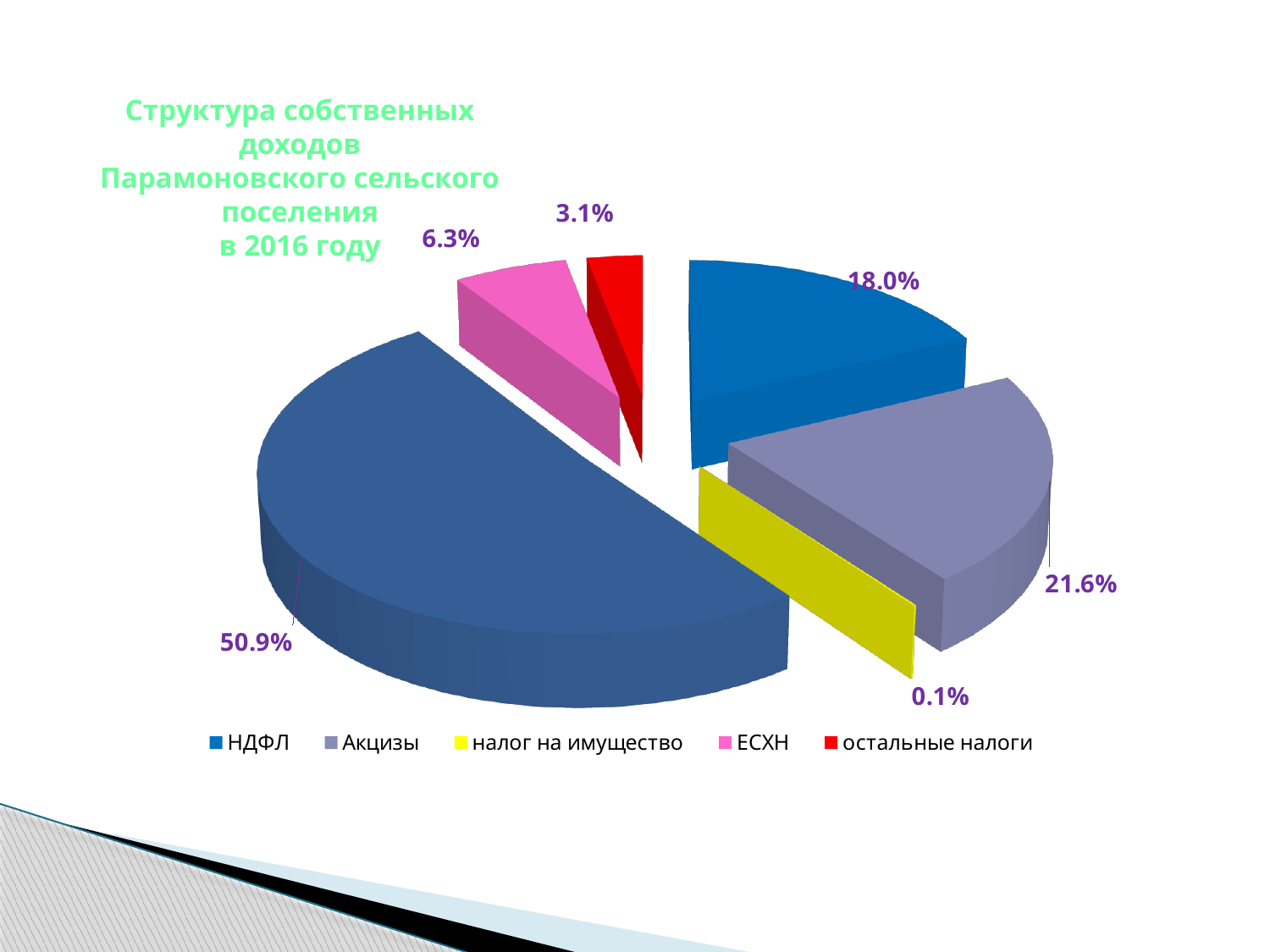
What is the largest percentage label shown on the pie chart? 50.9% What percentage does the Акцизы slice represent? 21.6% What share does налог на имущество have? 0.1% Which is larger, ЕСХН or остальные налоги? ЕСХН What percentage is labelled for НДФЛ? 18.0% How many entries does the legend list? 5 What is the value of the остальные налоги slice? 3.1% By how many percentage points does Акцизы exceed НДФЛ? 3.6% What percentage is shown for ЕСХН? 6.3% Which year does the chart title refer to? 2016 Which legend category has the smallest share? налог на имущество What type of chart is shown on the slide? pie chart